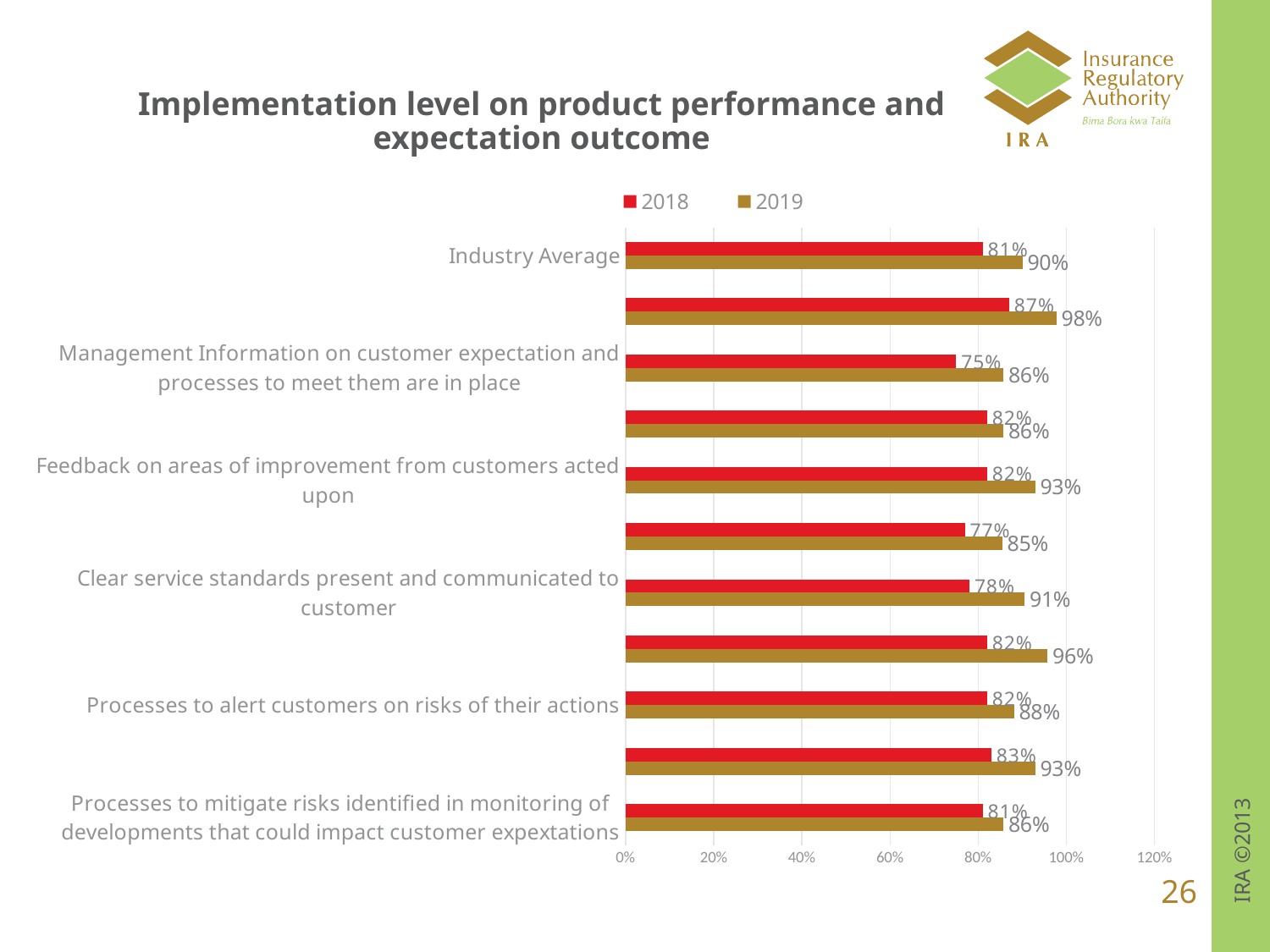
What kind of chart is shown on the slide? Bar chart By how many percentage points did 'Processes to mitigate risks identified in monitoring of developments that could impact customer expextations' increase from 2018 to 2019? 5% What is the 2018 value for 'Management Information on customer expectation and processes to meet them are in place'? 75% What is the 2019 value for 'Processes to alert customers on risks of their actions'? 88% What is the 2019 value for 'Clear service standards present and communicated to customer'? 91% What is the 2019 value for Industry Average? 90% What is the title of the chart on the slide? Implementation level on product performance and expectation outcome Which has the higher 2019 value: 'Feedback on areas of improvement from customers acted upon' or 'Clear service standards present and communicated to customer'? Feedback on areas of improvement from customers acted upon What is the 2018 value for Industry Average? 81% What is the difference between the 2019 and 2018 values for 'Management Information on customer expectation and processes to meet them are in place'? 11% How many series does the legend list? 2 What is the 2019 value for 'Feedback on areas of improvement from customers acted upon'? 93%